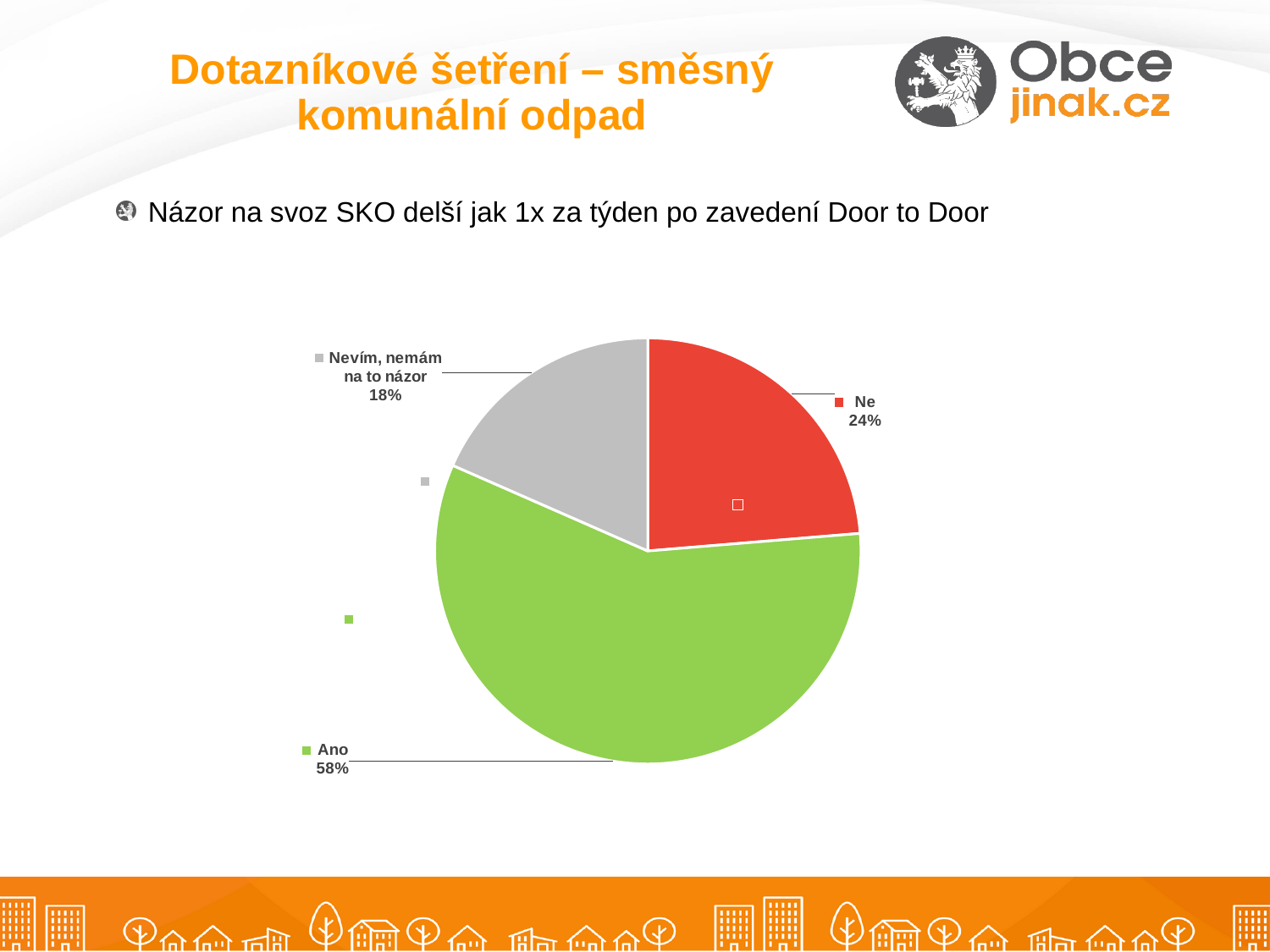
What kind of chart is shown on the slide? pie chart What percentage of respondents answered "Ne"? 24% What colour is the "Ne" slice? red What percentage of respondents answered "Nevím, nemám na to názor"? 18% What percentage of respondents answered "Ano"? 58% What is the difference in percentage points between "Ano" and "Ne"? 34 Which answer has the smallest share of the pie? Nevím, nemám na to názor Which is larger, the share for "Ne" or the share for "Nevím, nemám na to názor"? Ne What colour is the "Ano" slice? green What is the difference in percentage points between "Ne" and "Nevím, nemám na to názor"? 6 How many slices does the pie chart have? 3 Which answer has the largest share of the pie? Ano